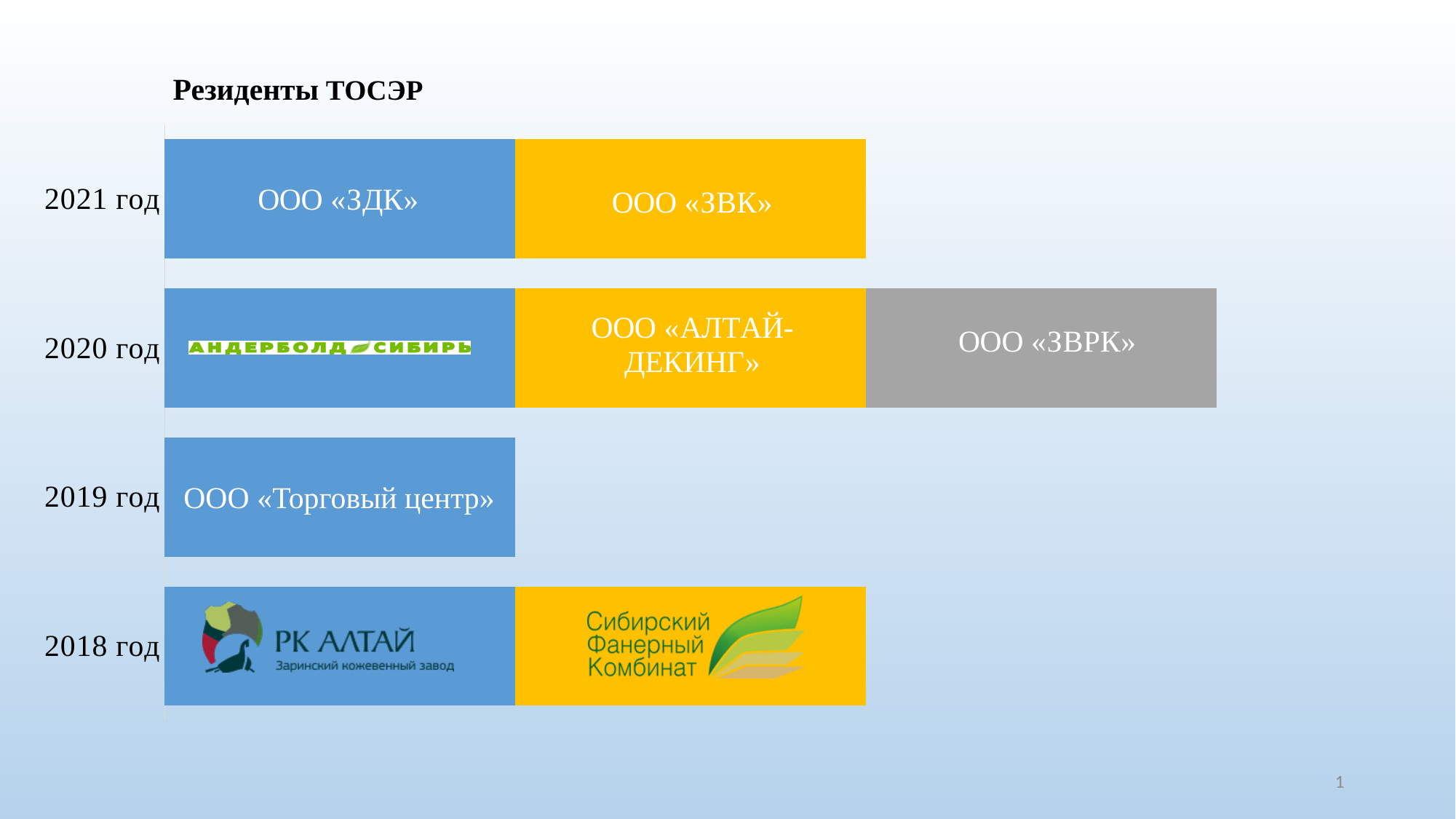
What is the title of the chart? Резиденты ТОСЭР Which year is listed at the bottom of the chart? 2018 год Which two residents are shown for 2021 год? ООО «ЗДК» and ООО «ЗВК» Which resident is shown for 2019 год? ООО «Торговый центр» Which year has the fewest resident segments in its bar? 2019 год What kind of chart is shown on the slide? bar chart How many year categories are shown on the chart? 4 Which year has the most resident segments in its bar? 2020 год How many resident segments are shown for 2020 год? 3 Which resident is shown in the grey segment for 2020 год? ООО «ЗВРК» How many resident segments are shown for 2019 год? 1 Which bar is longer, the one for 2021 год or the one for 2020 год? 2020 год